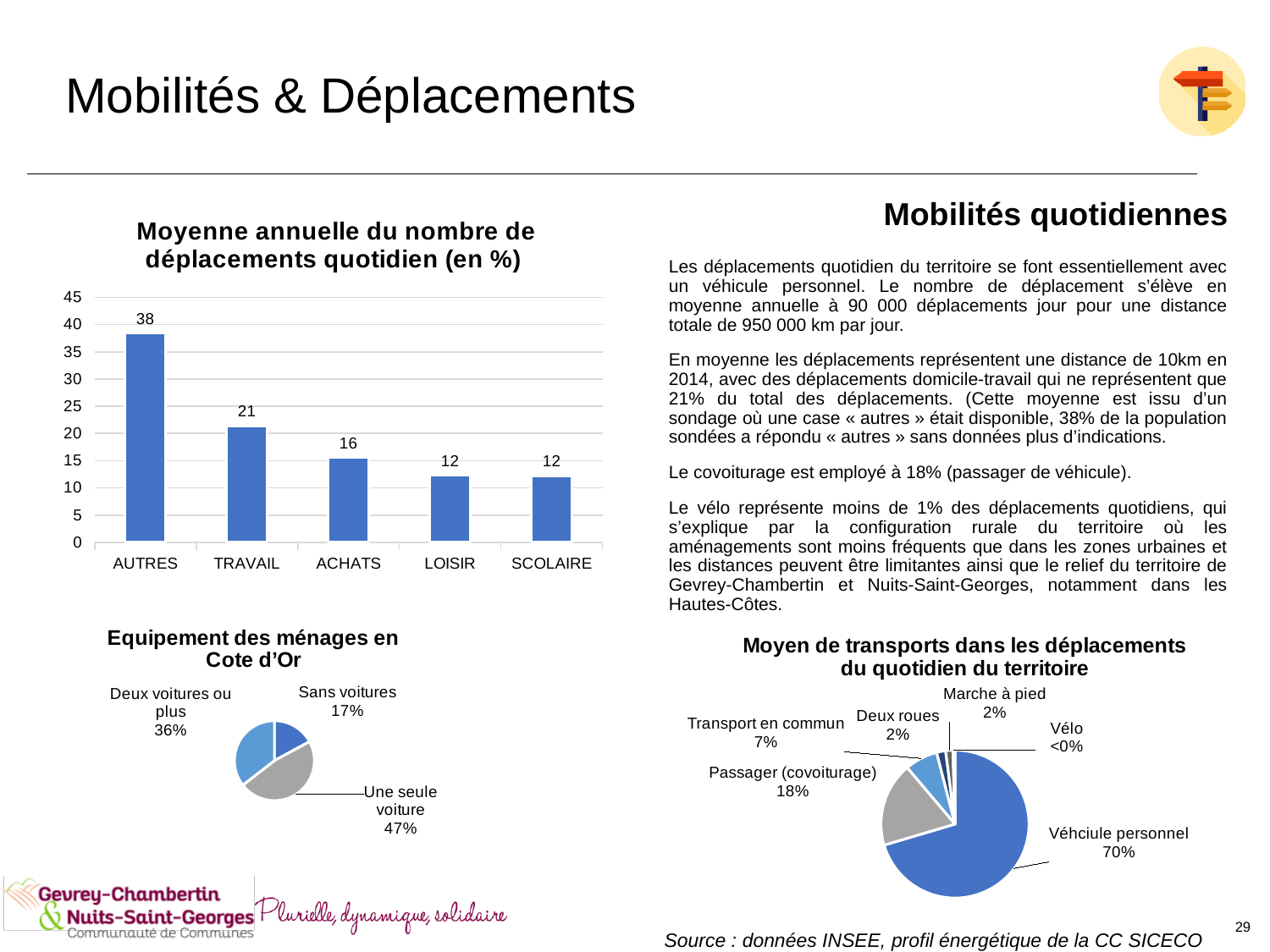
In the pie chart 'Equipement des ménages en Cote d'Or', which slice is the smallest? Sans voitures In the chart 'Moyenne annuelle du nombre de déplacements quotidien (en %)', do the values rise or fall from AUTRES to SCOLAIRE? Fall What kind of chart is 'Moyen de transports dans les déplacements du quotidien du territoire'? Pie chart In the pie chart 'Equipement des ménages en Cote d'Or', what share is 'Une seule voiture'? 47% In the chart 'Moyenne annuelle du nombre de déplacements quotidien (en %)', which category has the highest value? AUTRES In the pie chart 'Moyen de transports dans les déplacements du quotidien du territoire', what share is 'Passager (covoiturage)'? 18% In the chart 'Moyenne annuelle du nombre de déplacements quotidien (en %)', what is the value for TRAVAIL? 21 In the chart 'Moyenne annuelle du nombre de déplacements quotidien (en %)', which is larger, TRAVAIL or LOISIR? TRAVAIL In the chart 'Moyenne annuelle du nombre de déplacements quotidien (en %)', what is the difference between the values for AUTRES and ACHATS? 22 In the pie chart 'Moyen de transports dans les déplacements du quotidien du territoire', which slice is the largest? Véhciule personnel How many categories are shown in the chart 'Moyenne annuelle du nombre de déplacements quotidien (en %)'? 5 What kind of chart is 'Moyenne annuelle du nombre de déplacements quotidien (en %)'? Bar chart